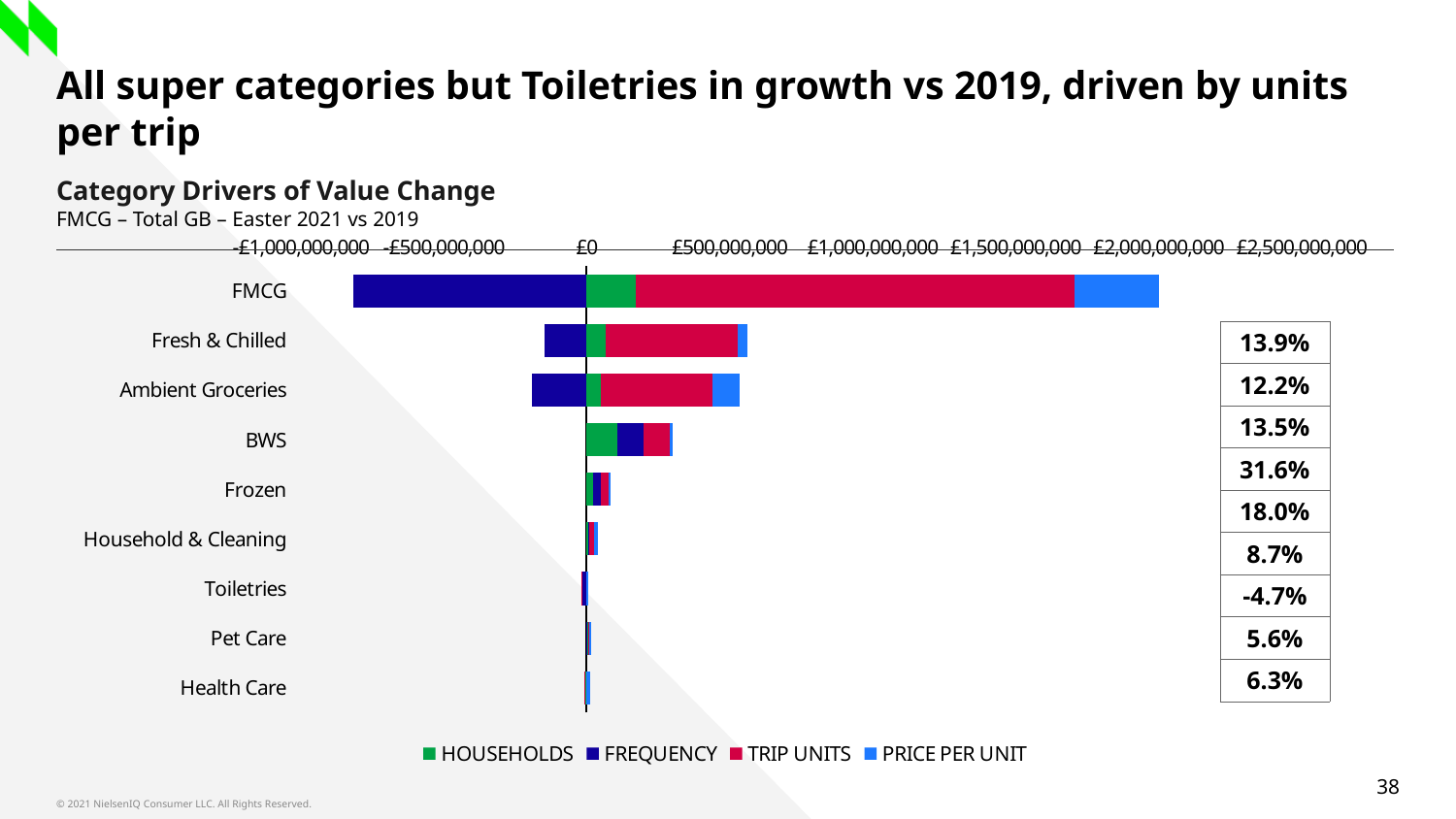
Which series contributes the largest positive segment for FMCG? TRIP UNITS Which has the larger positive bar, Fresh & Chilled or BWS? Fresh & Chilled What is the title of the chart? Category Drivers of Value Change Which series are listed in the legend? HOUSEHOLDS, FREQUENCY, TRIP UNITS, PRICE PER UNIT Is the positive value for FMCG greater or less than £1,500,000,000? greater How many categories are plotted on the chart? 9 Is the positive value for BWS greater or less than £500,000,000? less How many series does the legend list? 4 What kind of chart is shown on the slide? Stacked bar chart Is the positive value for Frozen greater or less than £500,000,000? less Which series has a negative contribution for FMCG? FREQUENCY Which category has the longest bar on the chart? FMCG